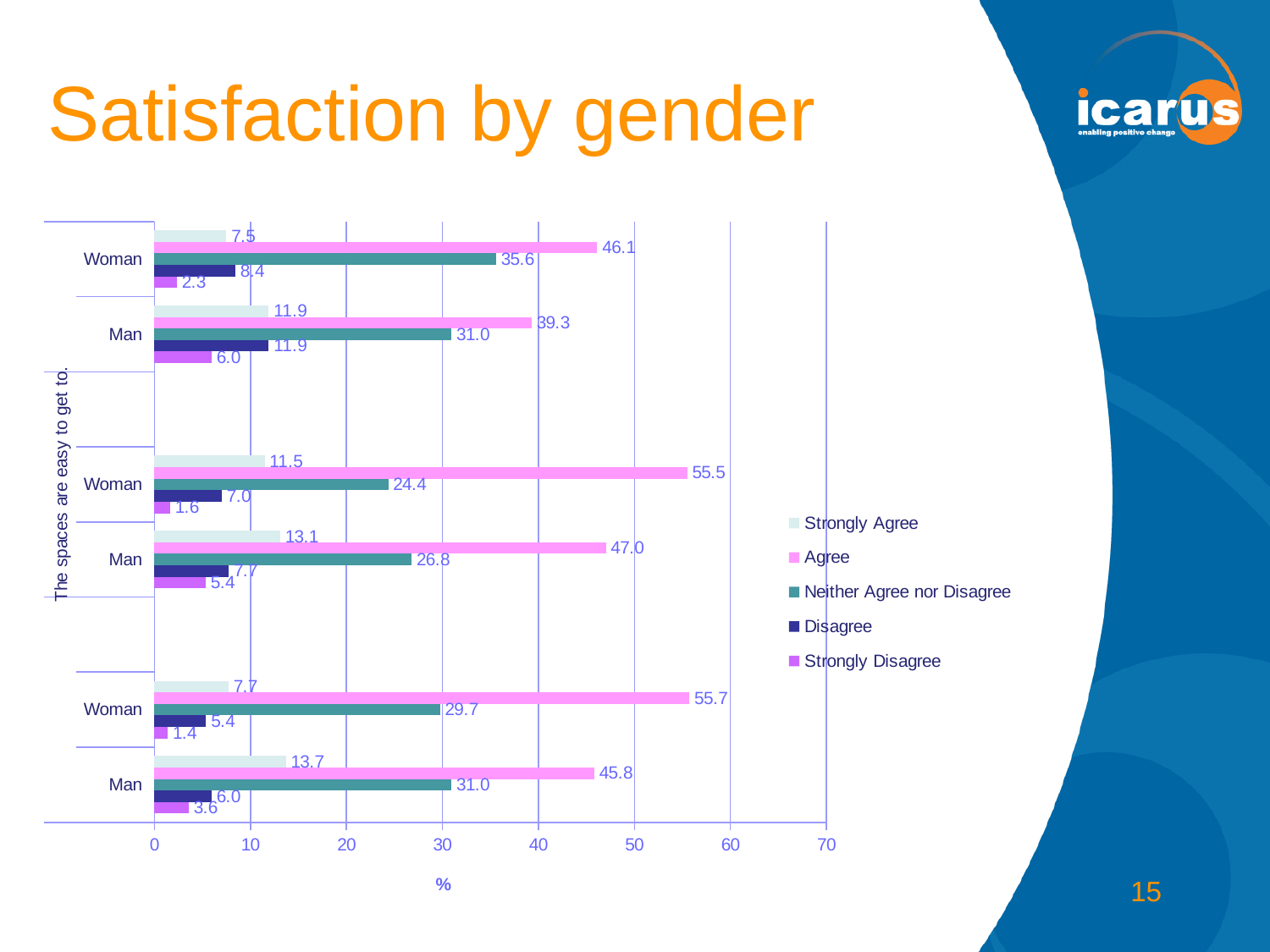
For the statement 'The spaces are easy to get to.', what percentage of men chose Strongly Agree? 13.1 For the statement 'The spaces are easy to get to.', which is larger: the Neither Agree nor Disagree value for Man or for Woman? Man In the bottom group of bars, what is the Strongly Disagree value for Man? 3.6 In the bottom group of bars, which response category has the lowest value for Woman? Strongly Disagree How many series does the legend list? 5 In the top group of bars, what is the difference between the Agree values for Woman (46.1) and Man (39.3)? 6.8 What is the title of the slide? Satisfaction by gender For the statement 'The spaces are easy to get to.', what percentage of women chose Agree? 55.5 What kind of chart is shown on the slide? Bar chart In the top group of bars, what is the Agree value for Woman? 46.1 In the bottom group of bars, which response category has the highest value for Woman? Agree What is the label on the horizontal axis? %